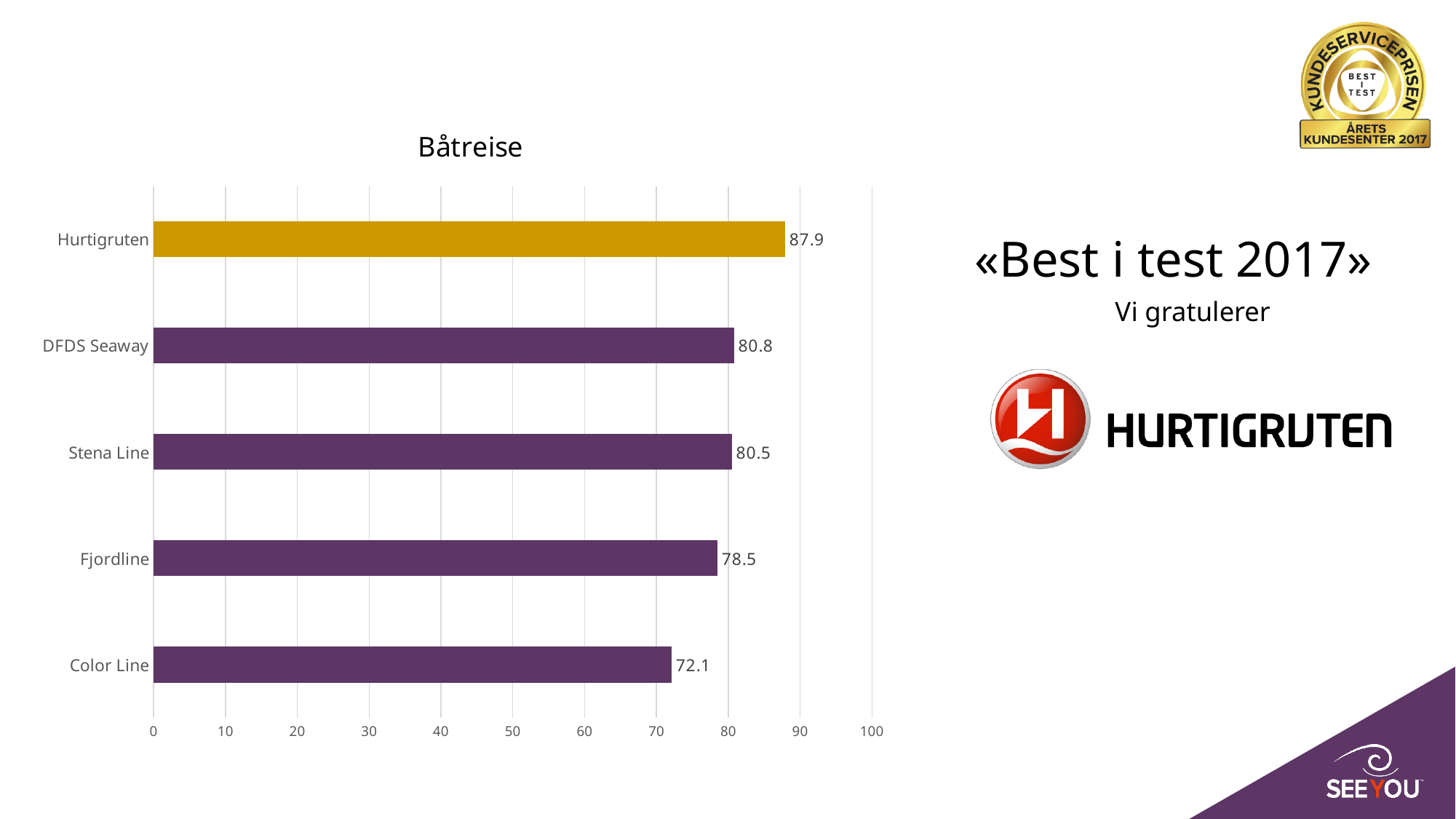
What is the title of the chart? Båtreise What is the value for Color Line? 72.1 What is the difference between the values for Fjordline and Color Line? 6.4 Which is larger, the value for Fjordline or the value for Color Line? Fjordline Which category has the highest value? Hurtigruten Is the value for Color Line greater or less than 80? less How many categories are shown in the chart? 5 What is the value for Hurtigruten? 87.9 What is the value for Stena Line? 80.5 Which category has the lowest value? Color Line What is the difference between the values for Hurtigruten and DFDS Seaway? 7.1 What kind of chart is shown on the slide? bar chart